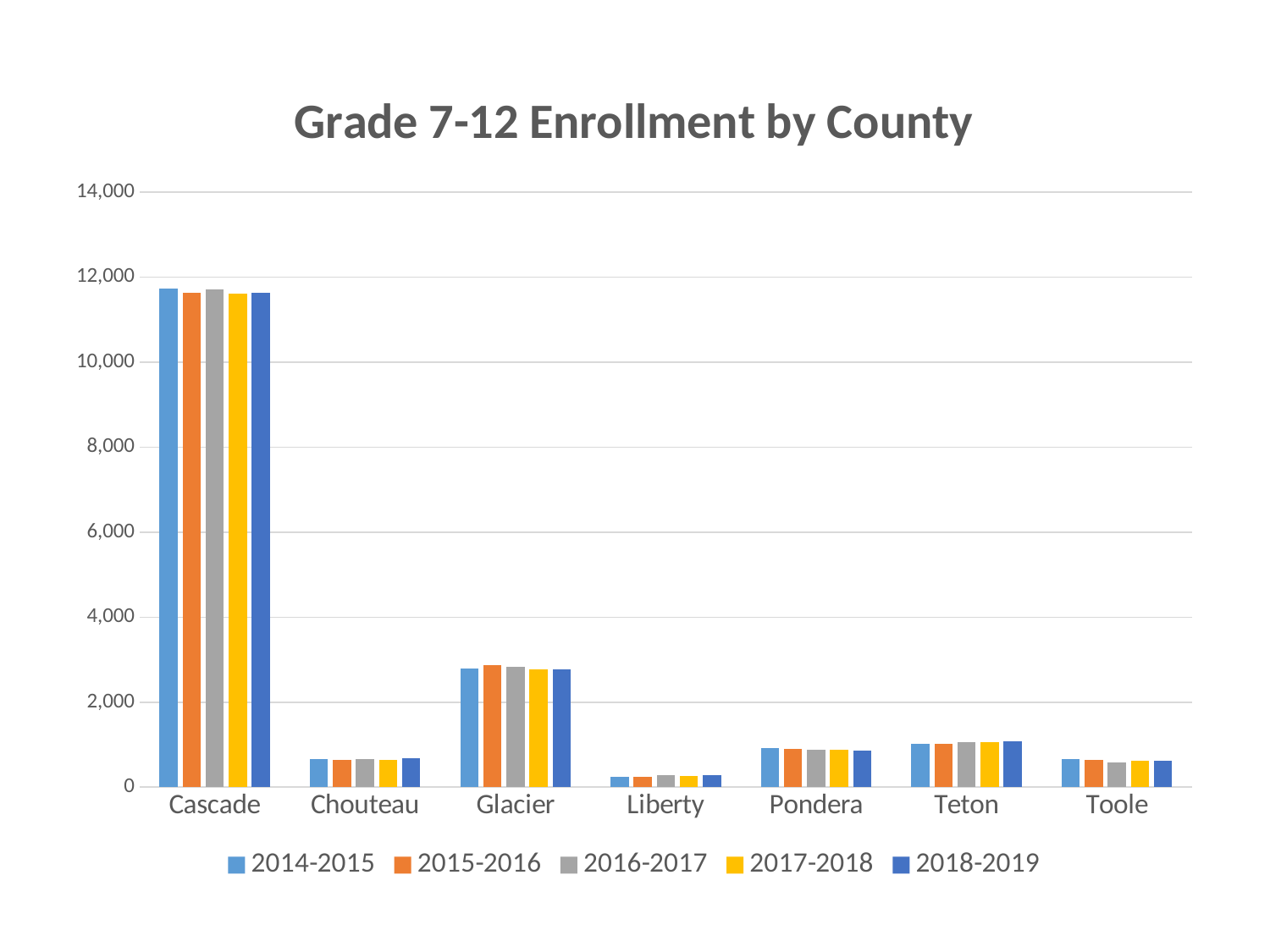
What kind of chart is shown on the slide? bar chart Is the 2018-2019 value for Teton greater or less than 2,000? less Which county has the highest Grade 7-12 enrollment? Cascade Is the 2016-2017 value for Liberty greater or less than 2,000? less How many series does the legend list? 5 Is the 2015-2016 value for Glacier greater or less than 2,000? greater What is the title of the chart? Grade 7-12 Enrollment by County Which legend entry is shown in orange? 2015-2016 Which county has the lowest Grade 7-12 enrollment? Liberty Which county has the larger 2017-2018 enrollment, Glacier or Chouteau? Glacier How many counties are shown on the x axis of the chart? 7